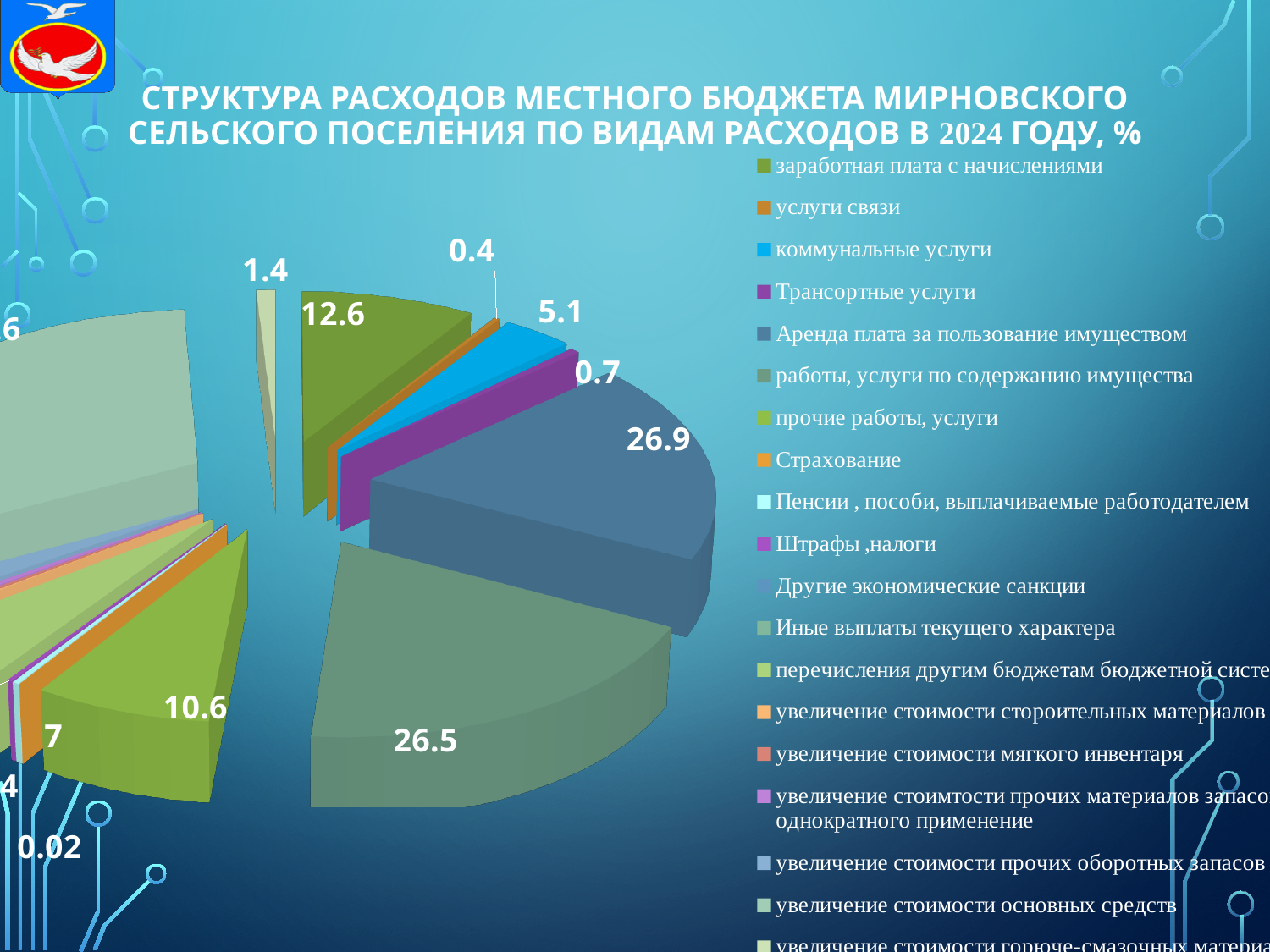
Which year does the chart title refer to? 2024 What is the value for заработная плата с начислениями? 12.6 What is the value for работы, услуги по содержанию имущества? 26.5 What type of chart is shown on the slide? pie chart Which category has the largest share of the pie? увеличение стоимости основных средств What is the value for Трансортные услуги? 0.7 What is the smallest value printed on the chart? 0.02 Which is larger: заработная плата с начислениями or прочие работы, услуги? заработная плата с начислениями What is the value for Аренда плата за пользование имуществом? 26.9 What is the difference between the values for Аренда плата за пользование имуществом and работы, услуги по содержанию имущества? 0.4 What is the value for прочие работы, услуги? 10.6 What is the value for коммунальные услуги? 5.1